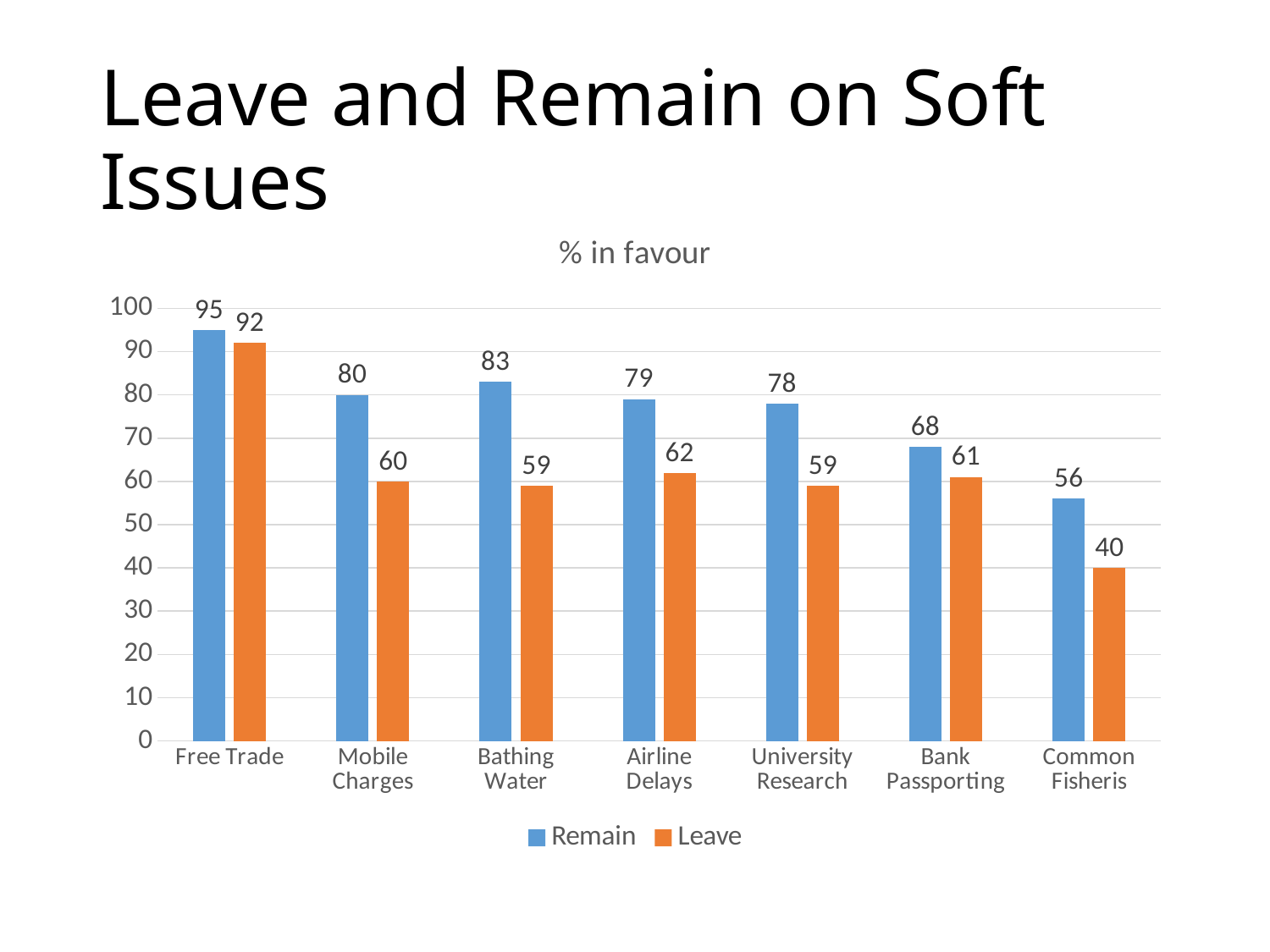
What kind of chart is shown on the slide? Bar chart What is the title of the chart? % in favour How many categories are shown on the x axis? 7 Is the Remain value for University Research greater or less than 70? greater What is the Remain value for Free Trade? 95 Which is larger for Bank Passporting, the Remain value or the Leave value? Remain Which category has the lowest Leave value? Common Fisheris What is the Leave value for Common Fisheris? 40 What is the Leave value for Airline Delays? 62 How many series does the legend list? 2 Which category has the highest Remain value? Free Trade What is the difference between the Remain and Leave values for Bathing Water? 24